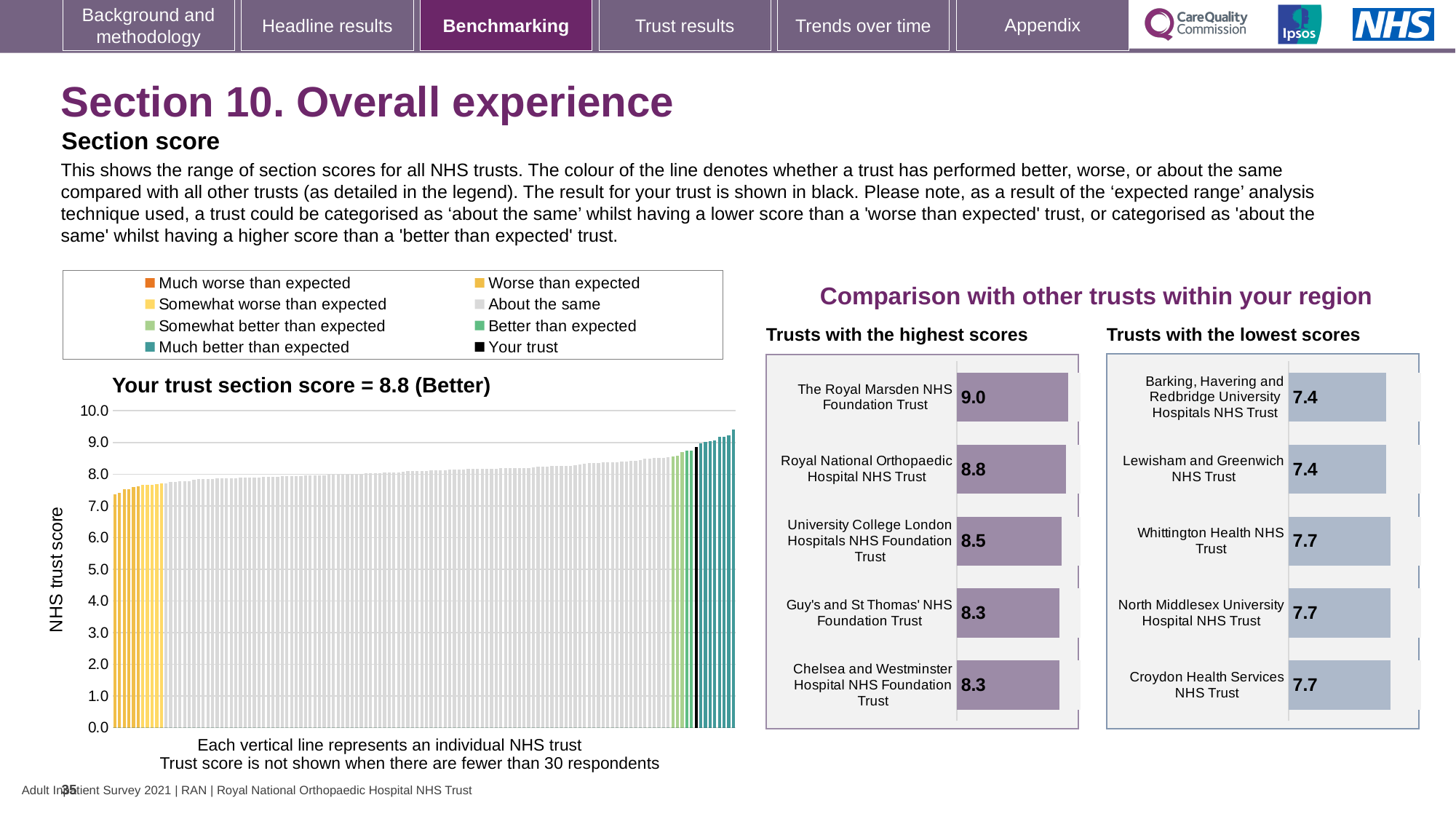
How many entries does the legend above the 'Your trust section score' chart list? 8 In the 'Your trust section score' chart on the left, what is the section score for your trust? 8.8 In the 'Trusts with the highest scores' chart, what is the score for The Royal Marsden NHS Foundation Trust? 9.0 In the 'Trusts with the lowest scores' chart, what is the score for Whittington Health NHS Trust? 7.7 In the 'Trusts with the lowest scores' chart, which is larger: the score for Croydon Health Services NHS Trust or for Barking, Havering and Redbridge University Hospitals NHS Trust? Croydon Health Services NHS Trust In the 'Your trust section score' chart on the left, do the trust scores rise or fall from left to right? rise In the 'Trusts with the lowest scores' chart, what is the difference between the scores of North Middlesex University Hospital NHS Trust and Lewisham and Greenwich NHS Trust? 0.3 In the 'Trusts with the lowest scores' chart, what is the score for Lewisham and Greenwich NHS Trust? 7.4 In the 'Trusts with the highest scores' chart, what is the score for University College London Hospitals NHS Foundation Trust? 8.5 In the 'Trusts with the highest scores' chart, which trust has the highest score? The Royal Marsden NHS Foundation Trust In the 'Trusts with the highest scores' chart, what is the difference between the scores of The Royal Marsden NHS Foundation Trust and Royal National Orthopaedic Hospital NHS Trust? 0.2 How many trusts are listed in the 'Trusts with the highest scores' chart? 5